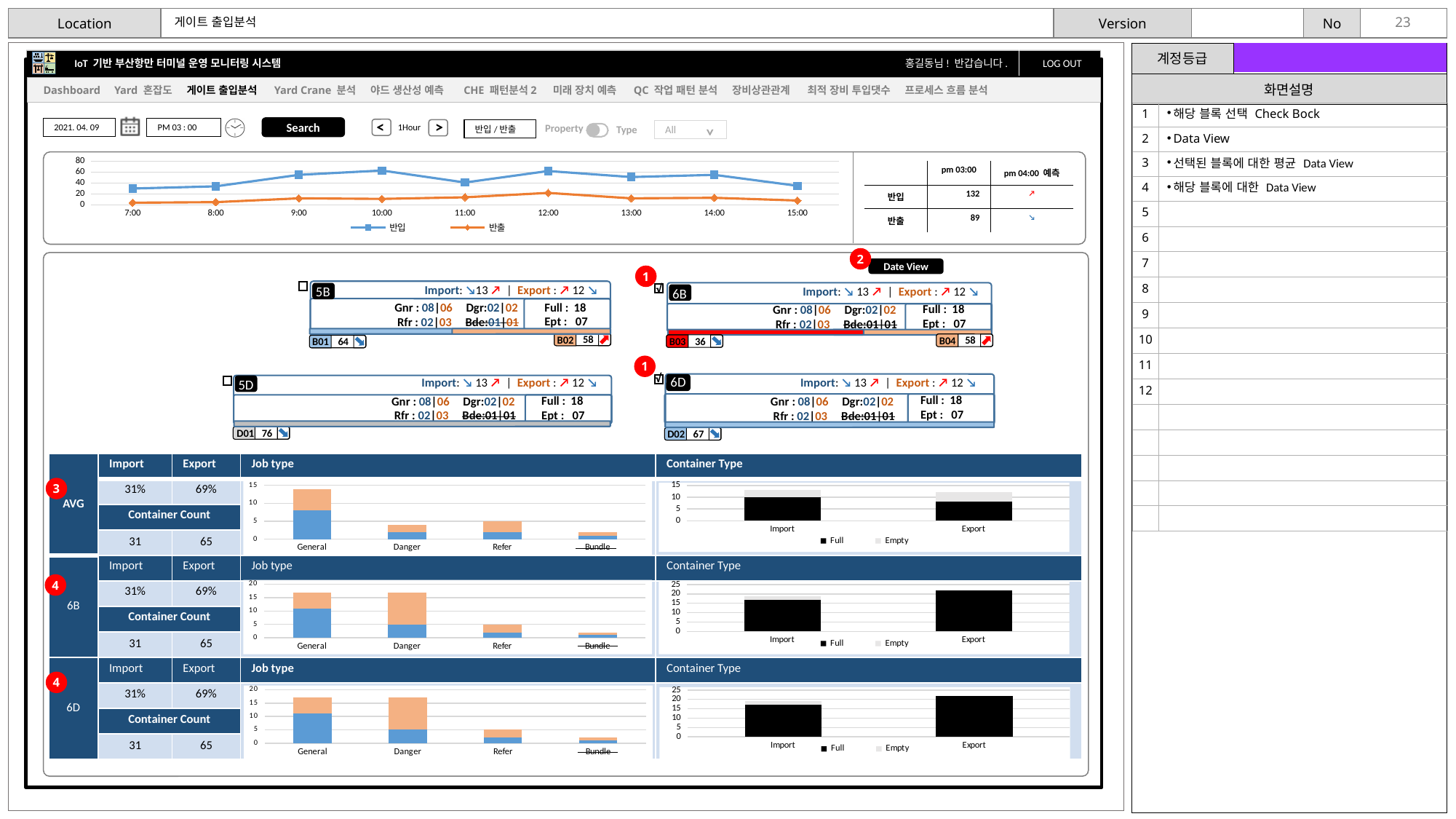
In the top line chart, how many time points are plotted along the x axis? 9 In the 6B Container Type chart, which category has the taller bar, Import or Export? Export What kind of chart is the chart at the top of the dashboard showing 반입 and 반출 from 7:00 to 15:00? line chart In the top line chart, which series has the larger value at 12:00, 반입 or 반출? 반입 In the top line chart, at which time is the 반출 value highest? 12:00 In the top line chart, is the 반출 value at 12:00 greater or less than 40? less In the top line chart, how many series does the legend list? 2 In the 6B Job type chart, which category has the lowest total bar? Bundle In the AVG Job type chart, which category has the highest total bar? General In the top line chart, is the 반입 value at 10:00 greater or less than 40? greater In the AVG Job type chart, how many job type categories are shown on the x axis? 4 What kind of chart is the AVG Job type chart? bar chart